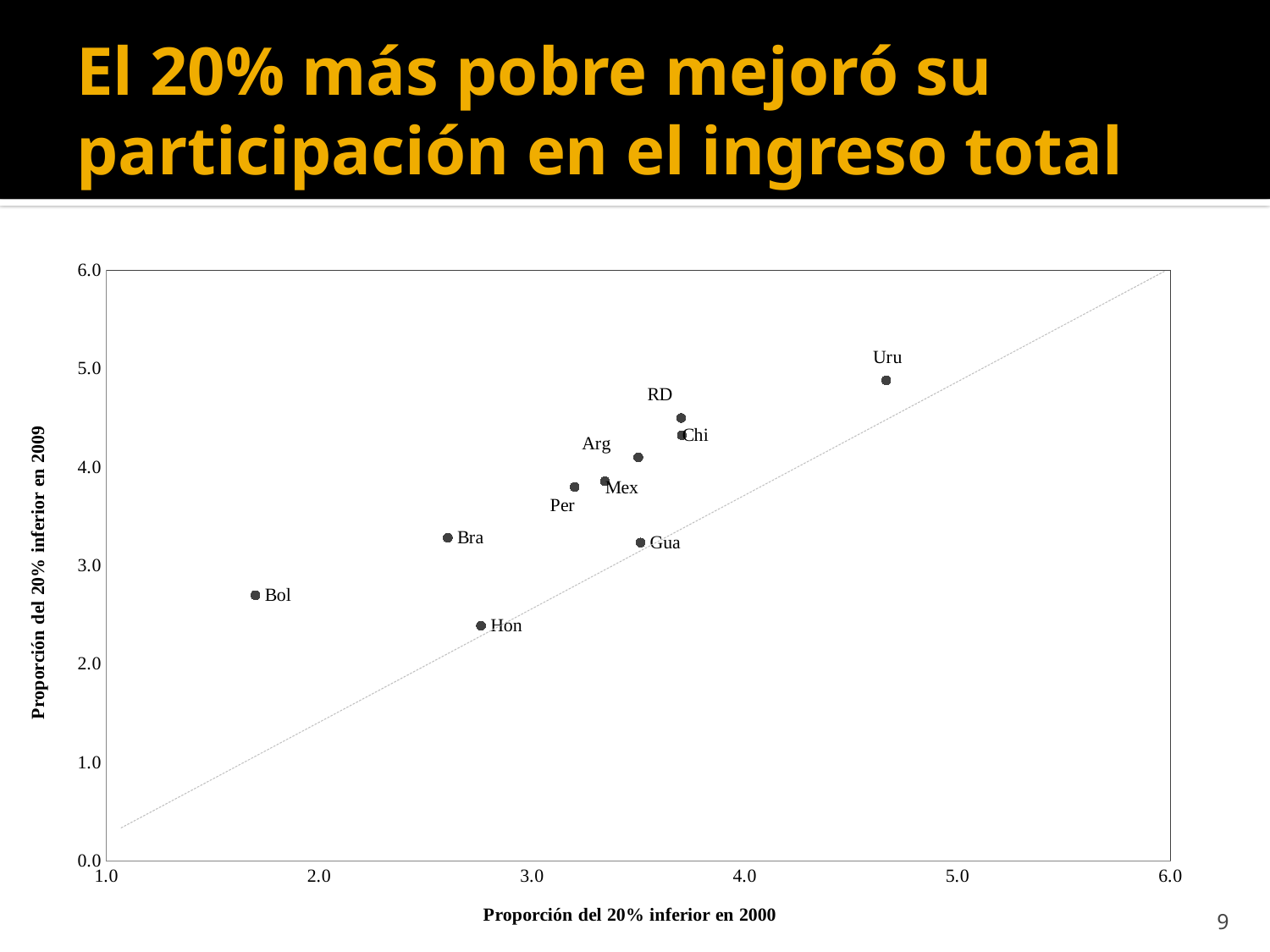
Which country has the lowest value on the horizontal axis (Proporción del 20% inferior en 2000)? Bol Is the 2009 value for Uru greater or less than 4.0? greater Which has the larger 2000 value, Uru or Gua? Uru What is the title of the horizontal axis? Proporción del 20% inferior en 2000 What kind of chart is shown on the slide? scatter chart How many countries are plotted as points on the chart? 10 Which has the larger 2009 value, Bra or Hon? Bra Is the 2009 value for RD greater or less than 4.0? greater Which country has the highest value on the vertical axis (Proporción del 20% inferior en 2009)? Uru Which country has the lowest value on the vertical axis (Proporción del 20% inferior en 2009)? Hon Is the 2009 value for Bol greater or less than 3.0? less